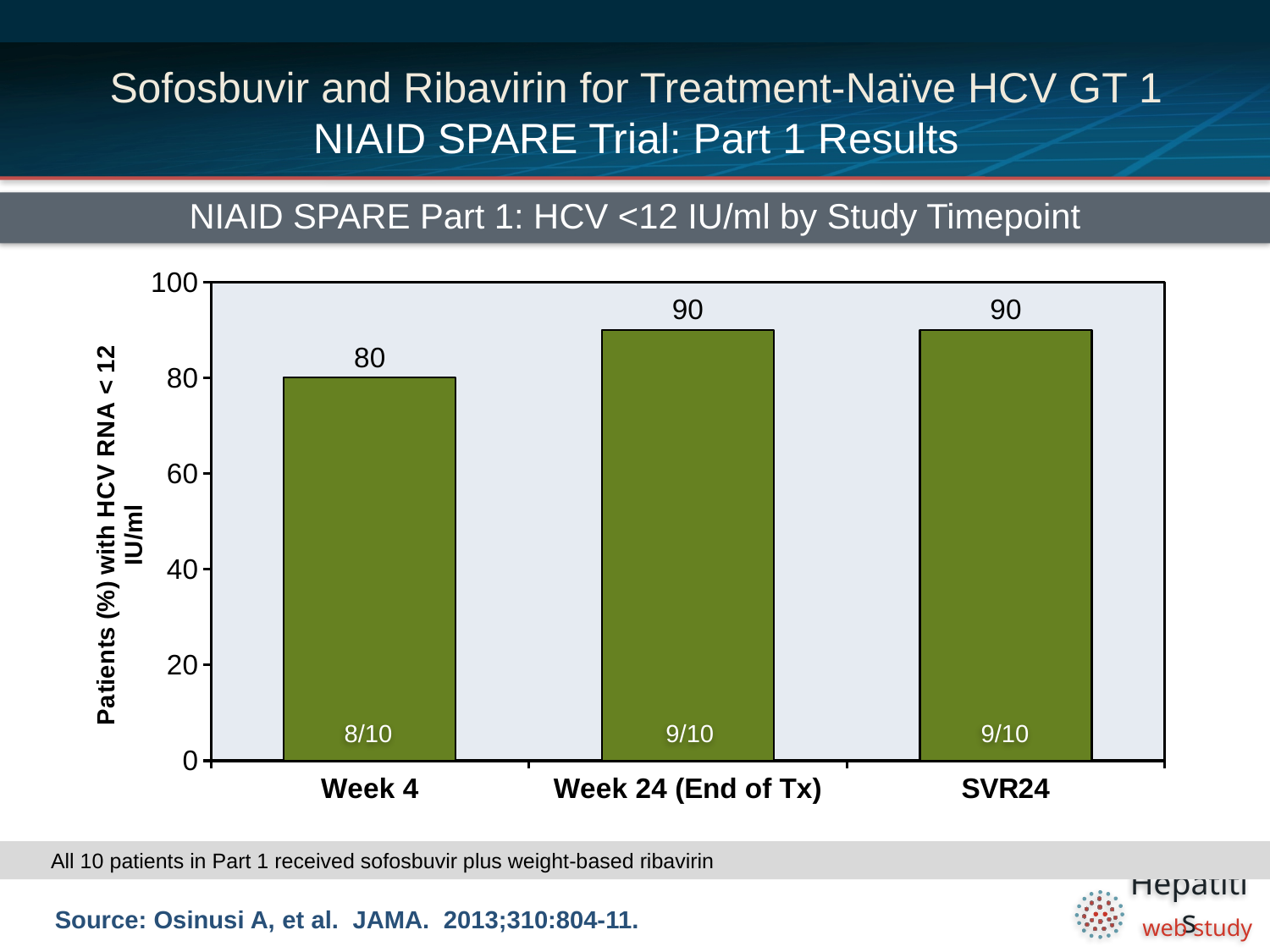
What is the value for SVR24? 90 Which is larger, the value for Week 4 or the value for SVR24? SVR24 How many timepoints are shown on the x axis? 3 What is the value for Week 24 (End of Tx)? 90 What is the difference between the values for Week 24 (End of Tx) and Week 4? 10 What fraction of patients is printed inside the Week 4 bar? 8/10 What is the title of the chart? NIAID SPARE Part 1: HCV <12 IU/ml by Study Timepoint Which timepoint has the lowest value? Week 4 What kind of chart is shown? bar chart Do the values rise or fall from Week 4 to Week 24 (End of Tx)? rise What is the value for Week 4? 80 Is the value for Week 4 greater or less than 60? greater